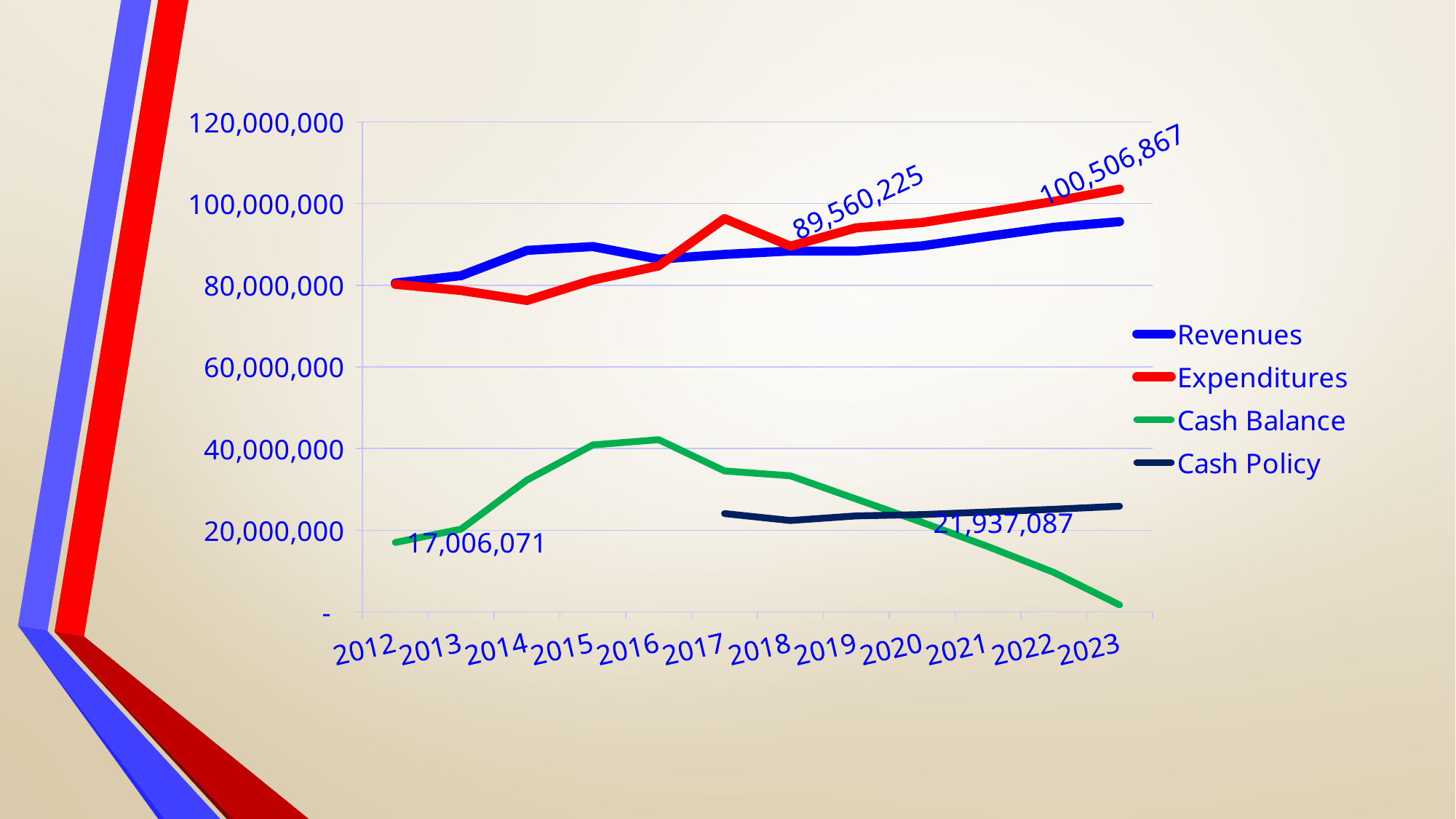
How many series does the legend list? 4 Is the Cash Balance value for 2023 greater or less than 20,000,000? less What is the Expenditures value labelled for 2018? 89,560,225 In 2023, which is larger: Revenues or Expenditures? Expenditures What is the Cash Balance value labelled for 2012? 17,006,071 Is the Revenues value for 2012 greater or less than 60,000,000? greater How many years are shown on the x axis? 12 What colour is the Cash Balance line in the legend? Green Does the Cash Balance line rise or fall from 2016 to 2023? Fall What type of chart is shown on the slide? Line chart